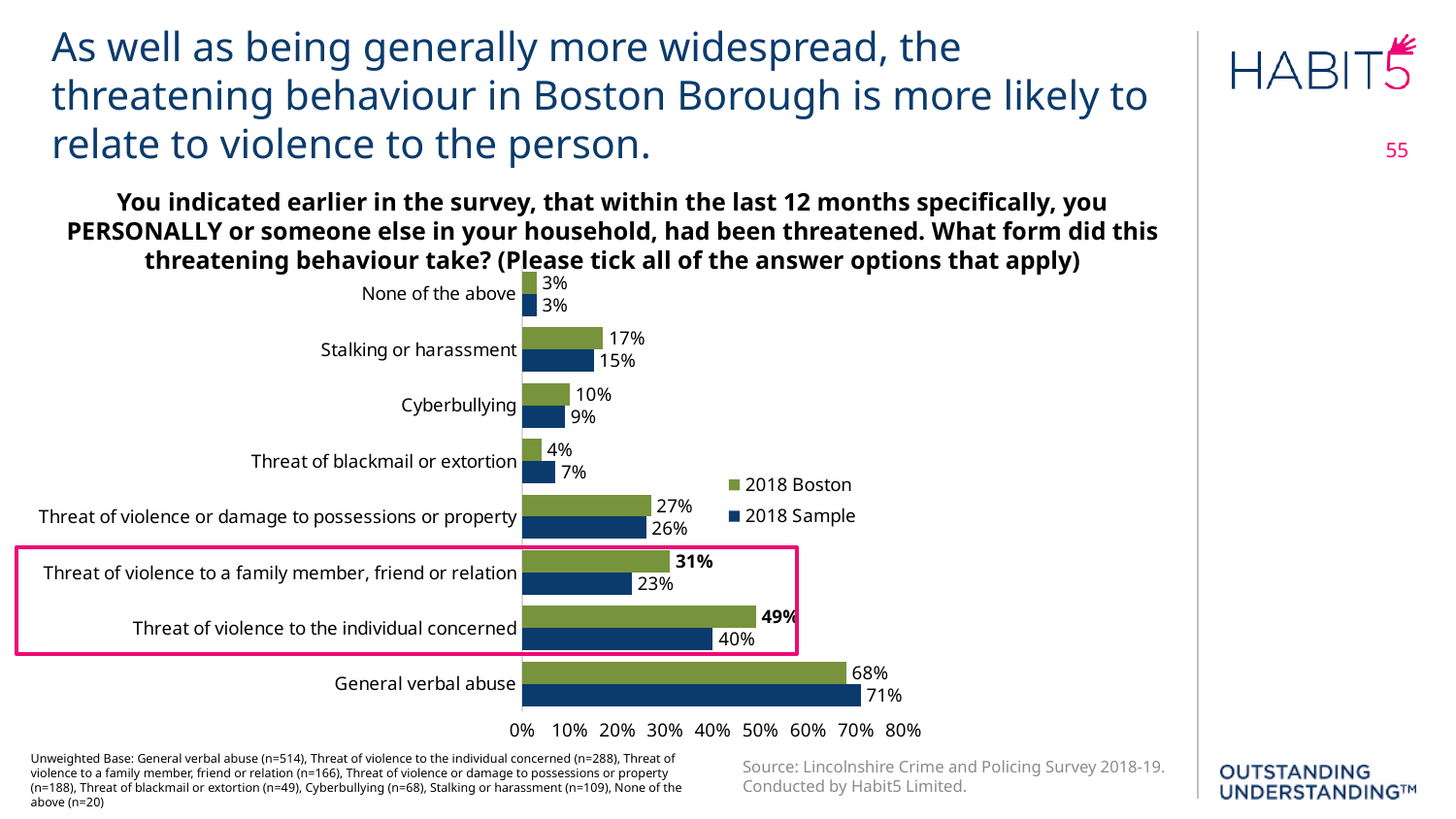
What is the 2018 Boston value for General verbal abuse? 68% What is the 2018 Sample value for Threat of violence to the individual concerned? 40% What is the 2018 Sample value for Threat of blackmail or extortion? 7% How many categories are shown on the chart? 8 What kind of chart is shown on the slide? Bar chart Which series is shown in green in the legend? 2018 Boston For General verbal abuse, which is larger: the 2018 Boston value or the 2018 Sample value? 2018 Sample What is the 2018 Boston value for Threat of violence to a family member, friend or relation? 31% What is the difference between the 2018 Boston and 2018 Sample values for Threat of violence to the individual concerned? 9% Which category has the highest 2018 Boston value? General verbal abuse Which category has the lowest 2018 Sample value? None of the above How many series does the legend list? 2